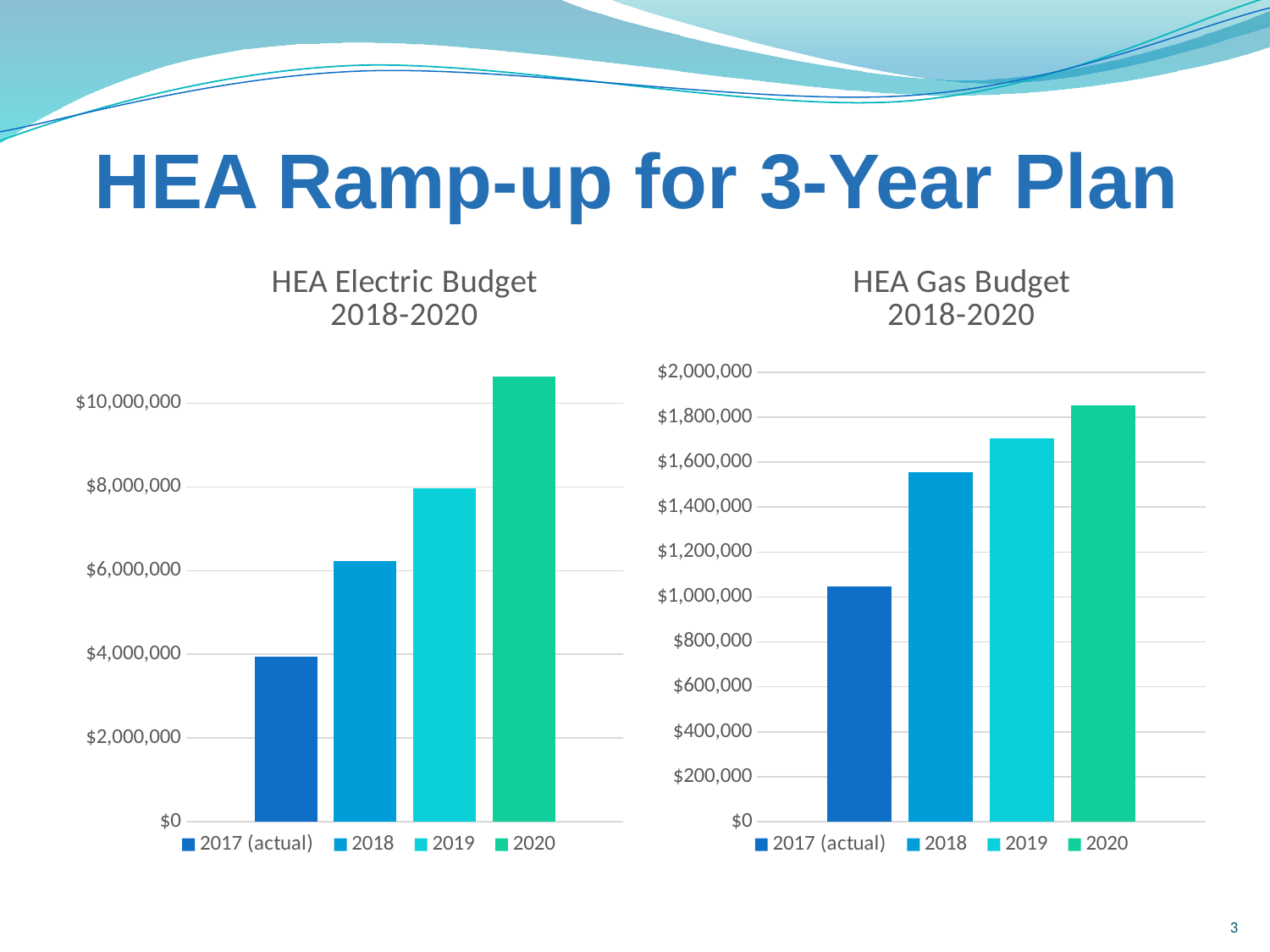
In the HEA Electric Budget 2018-2020 chart, which year has the highest budget? 2020 In the HEA Gas Budget 2018-2020 chart, is the value for 2020 greater or less than $2,000,000? less In the HEA Electric Budget 2018-2020 chart, do the values rise or fall from 2017 (actual) to 2020? rise In the HEA Gas Budget 2018-2020 chart, is the value for 2019 greater or less than $1,600,000? greater In the HEA Electric Budget 2018-2020 chart, which year has the lowest value? 2017 (actual) In the HEA Electric Budget 2018-2020 chart, is the value for 2020 greater or less than $10,000,000? greater In the HEA Gas Budget 2018-2020 chart, which is larger, the value for 2018 or the value for 2020? 2020 How many series does the legend of the HEA Gas Budget 2018-2020 chart list? 4 In the HEA Gas Budget 2018-2020 chart, which year has the lowest budget? 2017 (actual) How many bars are shown in the HEA Gas Budget 2018-2020 chart? 4 What kind of chart is the HEA Electric Budget 2018-2020 chart? bar chart